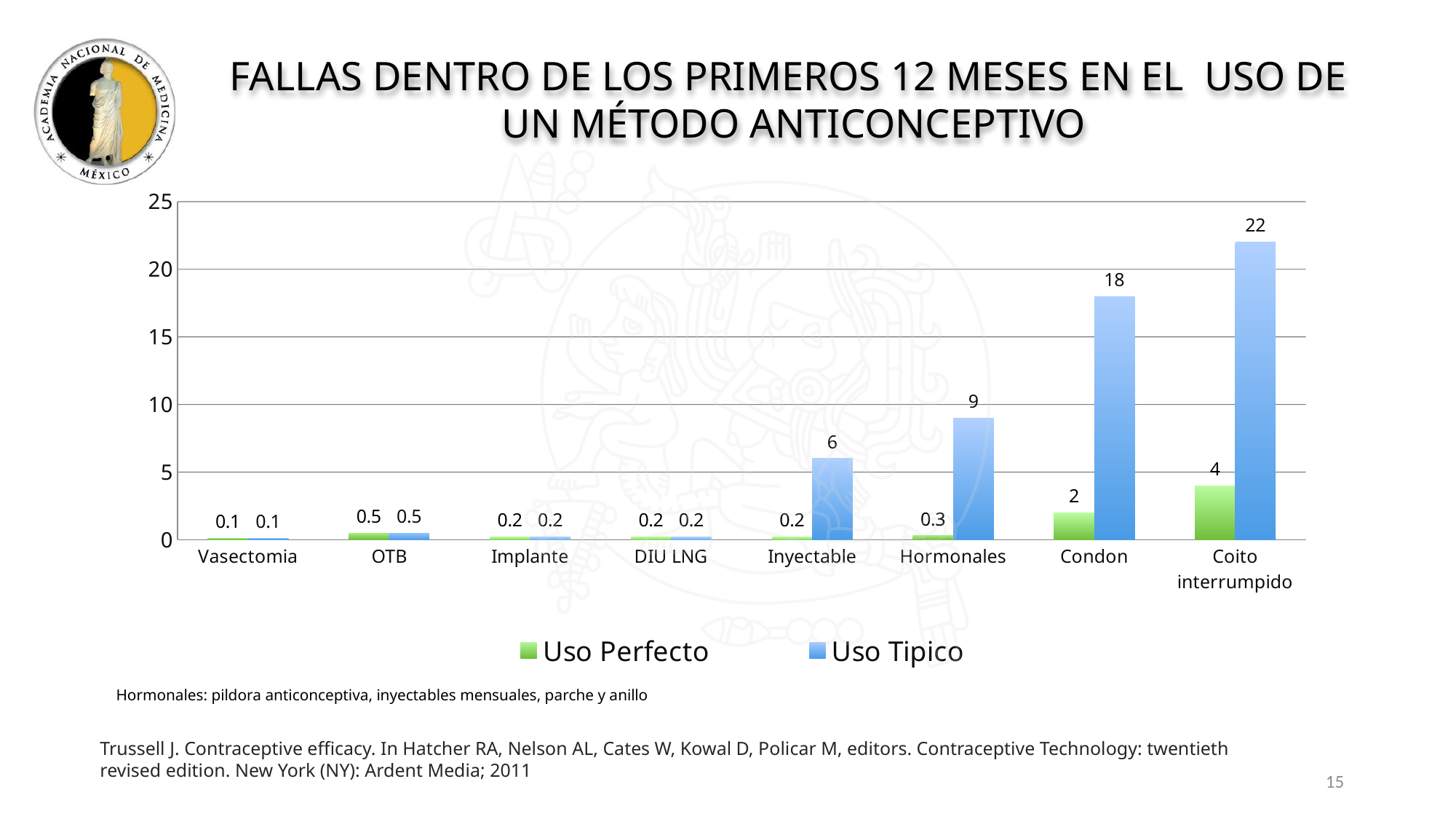
How many series does the legend list? 2 What is the Uso Perfecto value for OTB? 0.5 What is the Uso Perfecto value for Coito interrumpido? 4 What is the difference between the Uso Tipico and Uso Perfecto values for Condon? 16 Which category has the highest Uso Tipico value? Coito interrumpido Which category has the lowest Uso Perfecto value? Vasectomia What is the Uso Tipico value for Condon? 18 What is the Uso Tipico value for Hormonales? 9 Which is larger, the Uso Tipico value for Inyectable or for Hormonales? Hormonales What kind of chart is shown on the slide? Bar chart How many categories are shown on the x axis? 8 Which series is shown in blue in the legend? Uso Tipico